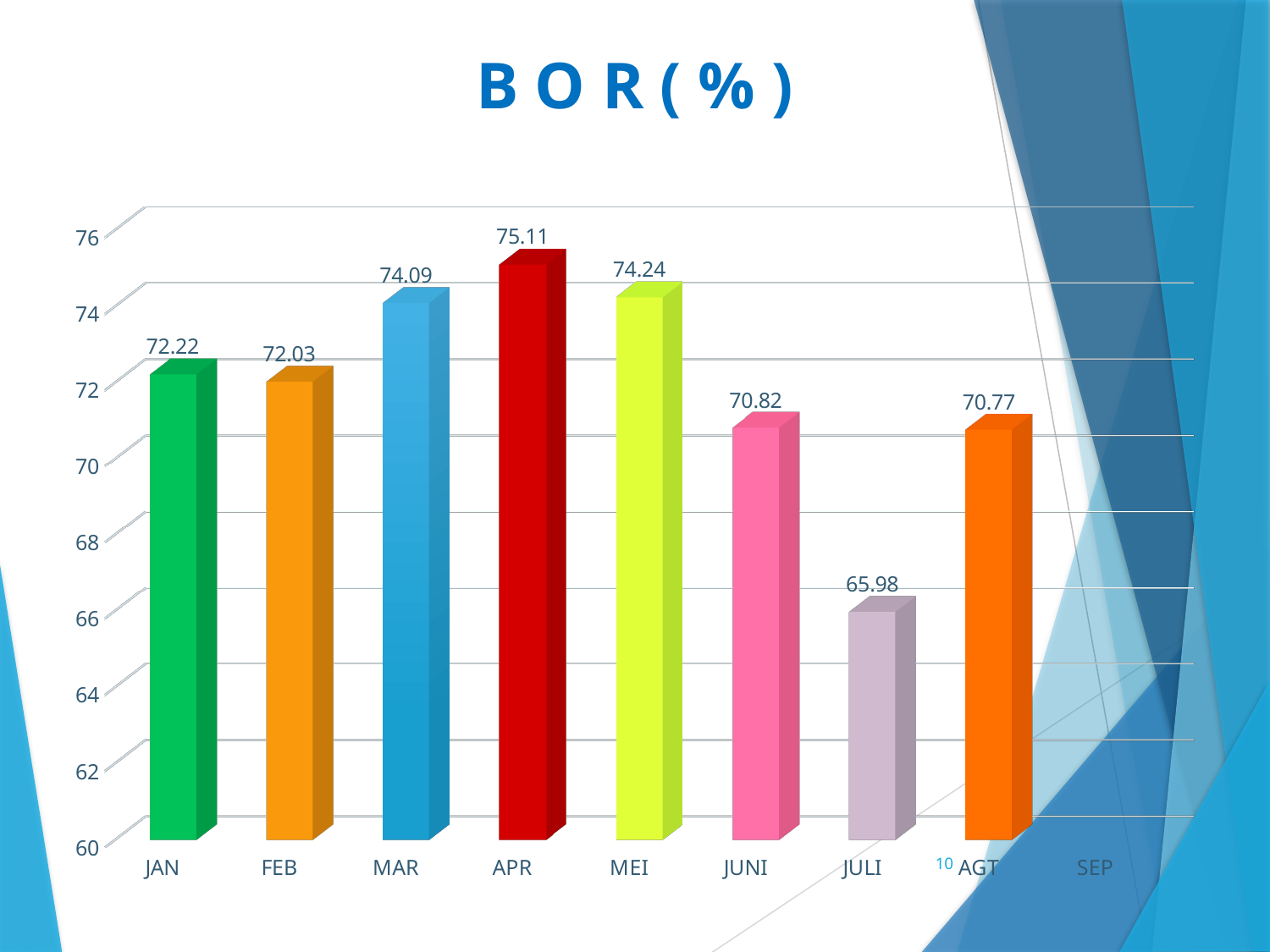
Which month has the highest BOR (%)? APR Which has a higher BOR (%), MAR or MEI? MEI How many bars are plotted in the chart? 8 What is the BOR (%) value for JULI? 65.98 Which month has the lowest BOR (%)? JULI What is the difference between the BOR (%) values for APR and JULI? 9.13 What kind of chart is shown on the slide? bar chart What is the BOR (%) value for AGT? 70.77 What is the difference between the BOR (%) values for JAN and FEB? 0.19 Do the BOR (%) values rise or fall from MEI to JULI? fall Is the BOR (%) value for JUNI greater or less than 70? greater What is the BOR (%) value for APR? 75.11